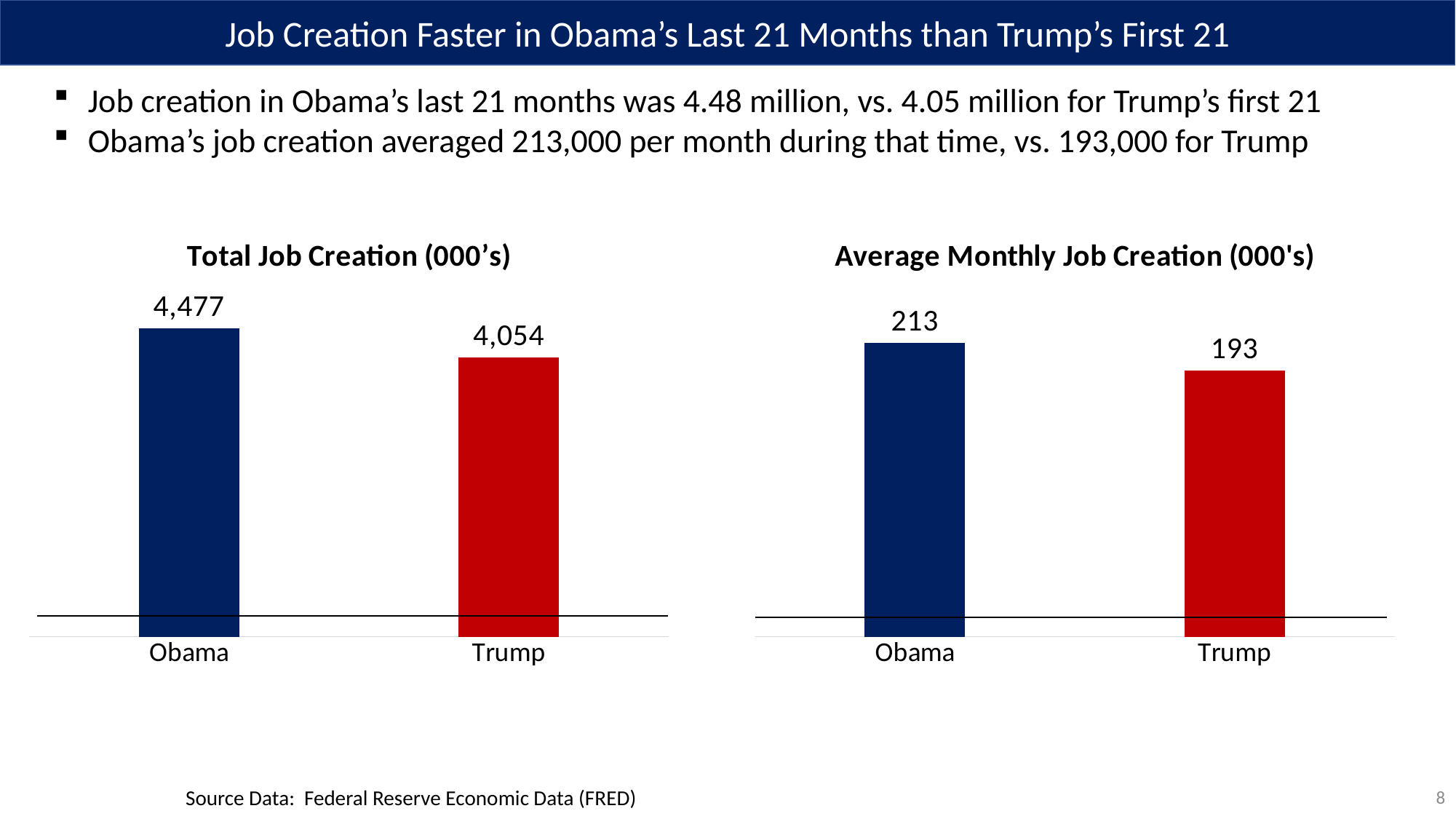
What kind of chart is the 'Average Monthly Job Creation (000's)' chart? Bar chart In the 'Total Job Creation (000's)' chart, which category has the highest value? Obama In the 'Total Job Creation (000's)' chart, what is the difference between the Obama and Trump values? 423 In the 'Total Job Creation (000's)' chart, what is the value for Obama? 4,477 How many categories are shown in the 'Total Job Creation (000's)' chart? 2 In the 'Total Job Creation (000's)' chart, what colour is the Trump bar? Red In the 'Average Monthly Job Creation (000's)' chart, what is the difference between the Obama and Trump values? 20 In the 'Average Monthly Job Creation (000's)' chart, what is the value for Trump? 193 In the 'Total Job Creation (000's)' chart, what is the value for Trump? 4,054 In the 'Average Monthly Job Creation (000's)' chart, what is the value for Obama? 213 In the 'Average Monthly Job Creation (000's)' chart, which is larger, the value for Obama or the value for Trump? Obama In the 'Average Monthly Job Creation (000's)' chart, which category has the lowest value? Trump